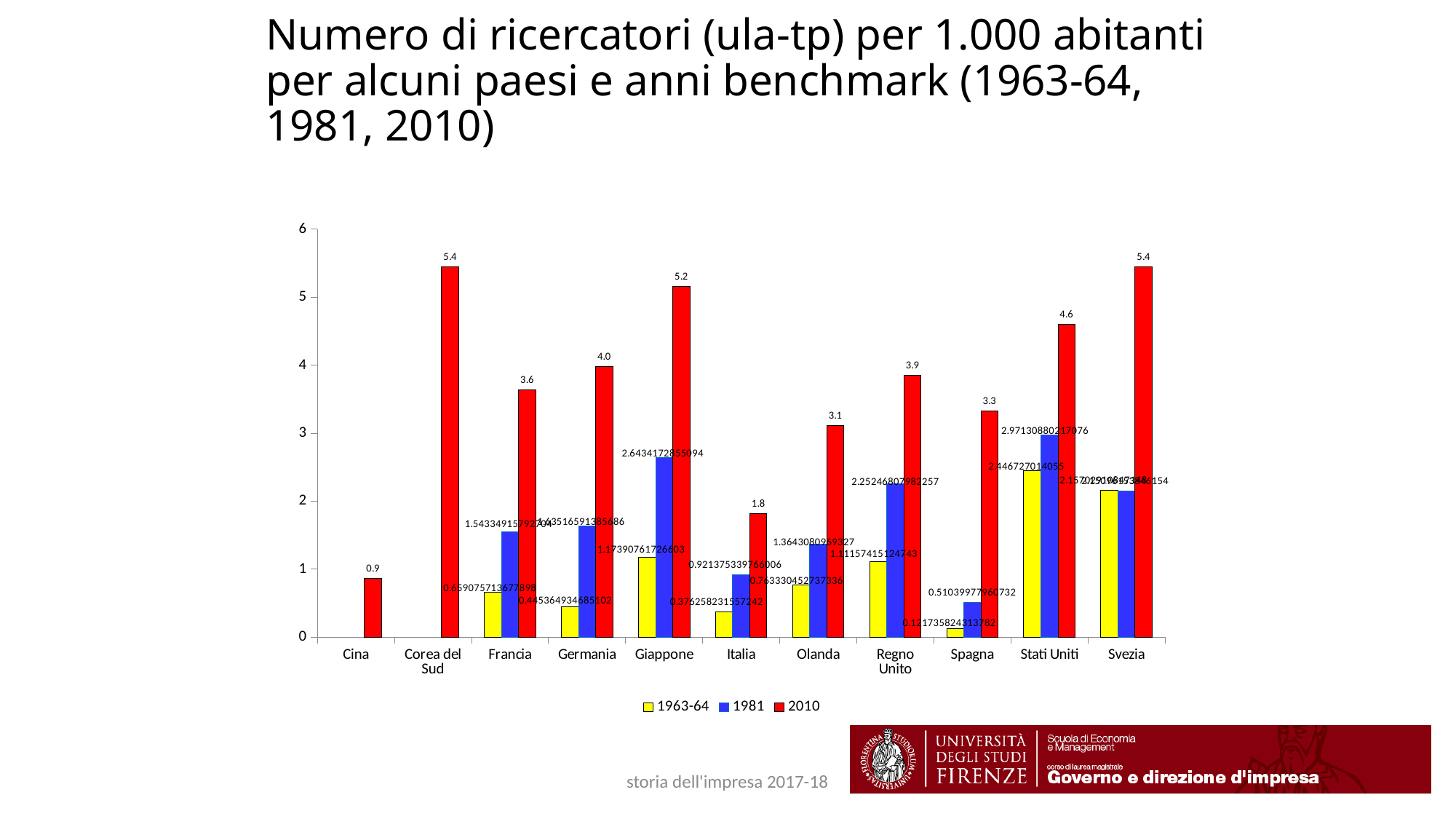
What is the value for Giappone in the 2010 series? 5.2 Which country has the lowest value in the 2010 series? Cina Is the value for Stati Uniti in the 1981 series greater or less than 2? greater What is the value for Germania in the 2010 series? 4.0 What is the value for Italia in the 2010 series? 1.8 How many series does the legend list? 3 What is the difference between the 2010 values for Corea del Sud and Cina? 4.5 Is the value for Spagna in the 1963-64 series greater or less than 1? less How many countries are shown on the x axis? 11 What is the value for Spagna in the 2010 series? 3.3 Which is larger in the 2010 series: Francia or Olanda? Francia What is the difference between the 2010 values for Stati Uniti and Regno Unito? 0.7